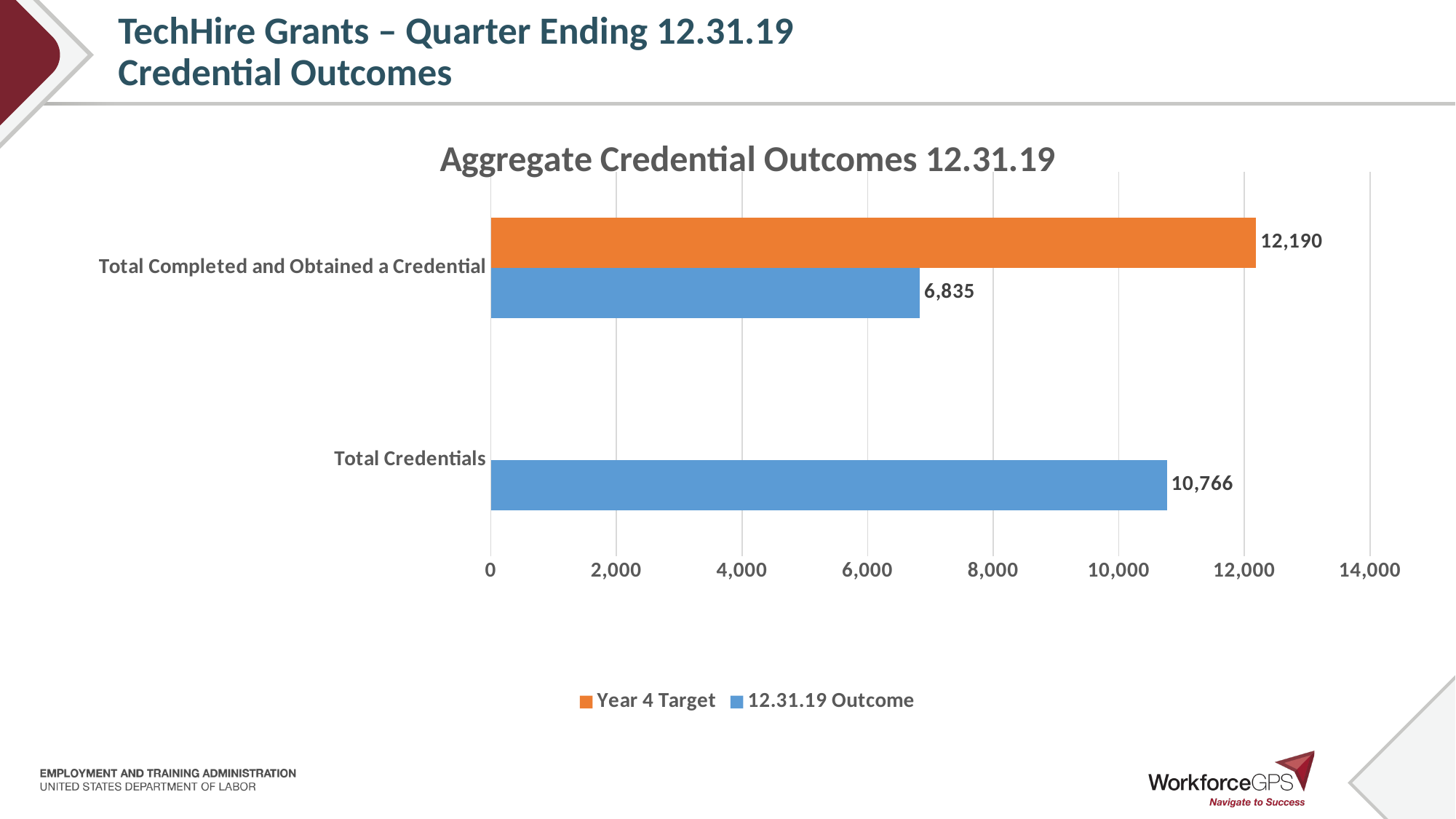
What is the 12.31.19 Outcome value for Total Completed and Obtained a Credential? 6,835 How many categories are shown on the y axis of the chart? 2 How many series does the legend list? 2 Which category has the lowest 12.31.19 Outcome value? Total Completed and Obtained a Credential What is the difference between the Year 4 Target and the 12.31.19 Outcome for Total Completed and Obtained a Credential? 5,355 Is the 12.31.19 Outcome value for Total Credentials greater or less than 10,000? greater What kind of chart is shown on the slide? Bar chart What is the 12.31.19 Outcome value for Total Credentials? 10,766 Which is larger: the Year 4 Target for Total Completed and Obtained a Credential or the 12.31.19 Outcome for Total Credentials? Year 4 Target for Total Completed and Obtained a Credential Which category has the highest 12.31.19 Outcome value? Total Credentials What is the Year 4 Target value for Total Completed and Obtained a Credential? 12,190 What is the difference between the 12.31.19 Outcome for Total Credentials and the 12.31.19 Outcome for Total Completed and Obtained a Credential? 3,931